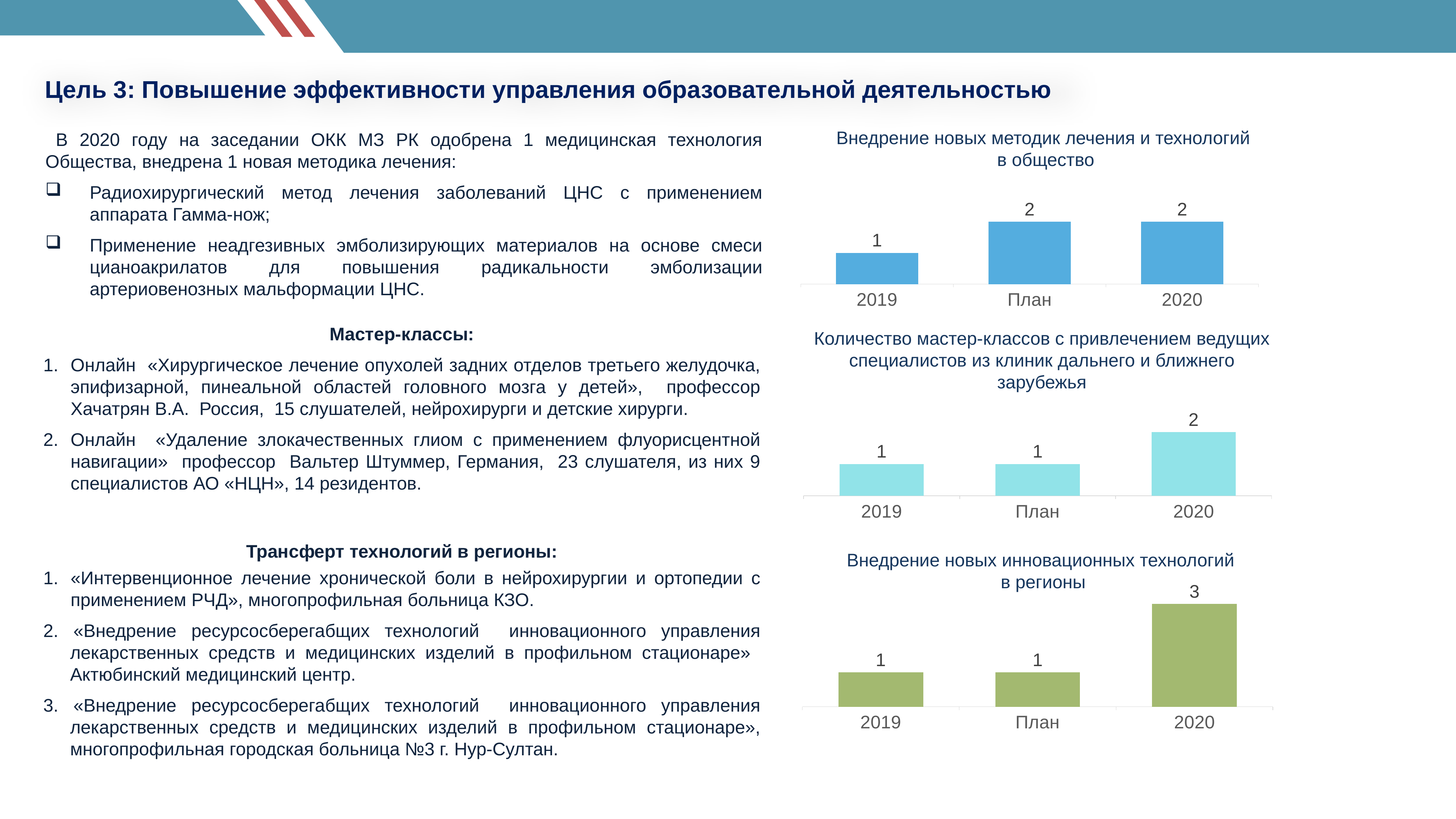
In the bottom chart 'Внедрение новых инновационных технологий в регионы', do the values rise or fall from 2019 to 2020? rise What colour are the bars in the bottom chart 'Внедрение новых инновационных технологий в регионы'? green What type of chart is the bottom chart 'Внедрение новых инновационных технологий в регионы'? bar chart In the top chart 'Внедрение новых методик лечения и технологий в общество', what is the value for 2019? 1 In the middle chart 'Количество мастер-классов...', what is the value for План? 1 In the top chart 'Внедрение новых методик лечения и технологий в общество', how many categories are shown on the x axis? 3 In the top chart 'Внедрение новых методик лечения и технологий в общество', what is the difference between the 2020 value and the 2019 value? 1 In the middle chart 'Количество мастер-классов...', is the value for 2020 larger than the value for План? Yes In the bottom chart 'Внедрение новых инновационных технологий в регионы', what is the value for 2020? 3 In the top chart 'Внедрение новых методик лечения и технологий в общество', what is the value for 2020? 2 In the bottom chart 'Внедрение новых инновационных технологий в регионы', what is the difference between the 2020 value and the План value? 2 In the middle chart 'Количество мастер-классов...', which category has the highest value? 2020